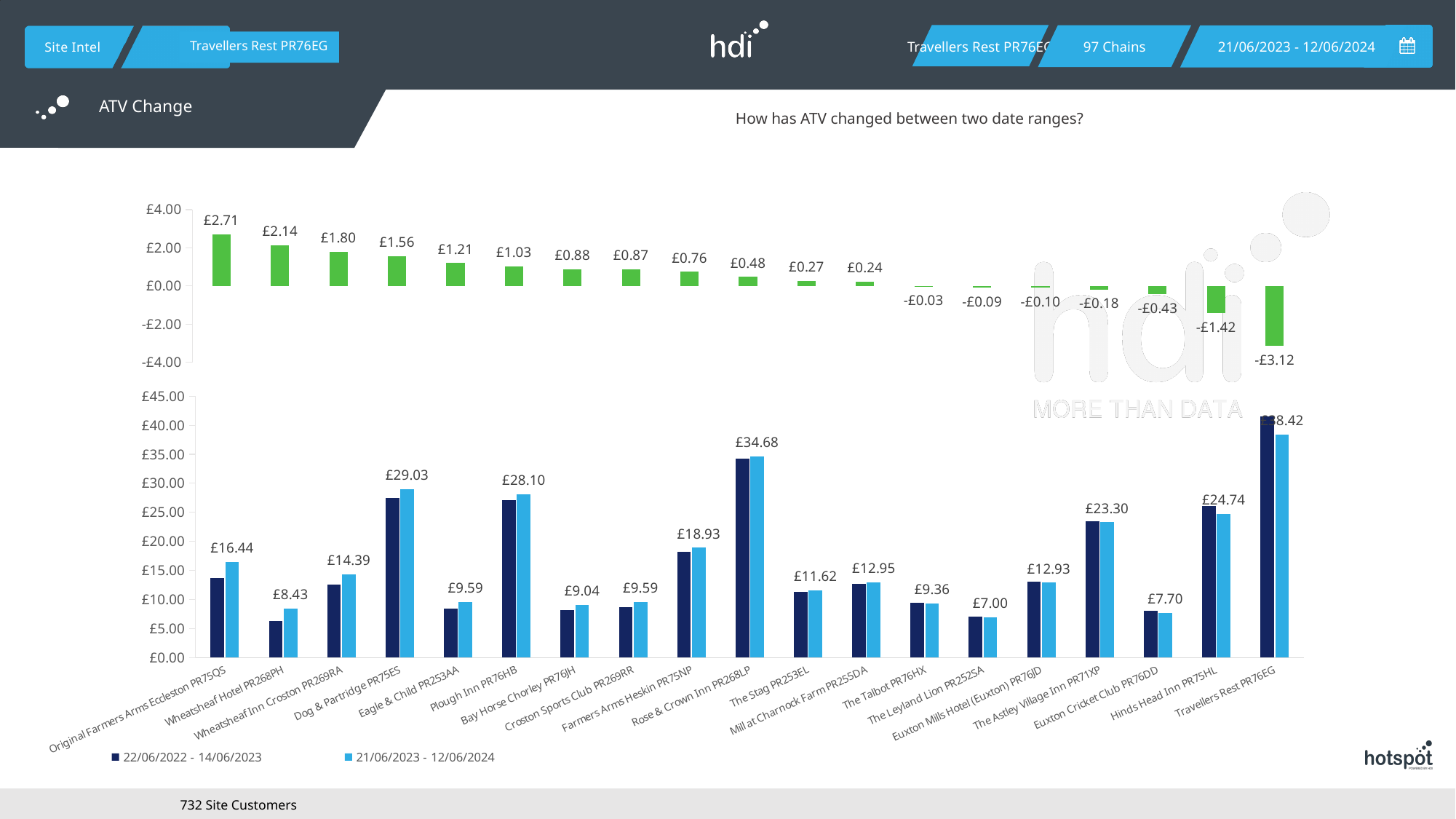
What kind of chart is the bottom chart? bar chart In the top chart, what is the difference between the values for Dog & Partridge PR75ES and Plough Inn PR76HB? £0.53 How many series does the legend of the bottom chart list? 2 In the bottom chart, is the 22/06/2022 - 14/06/2023 value for Dog & Partridge PR75ES greater or less than £25.00? greater How many sites are shown on the x axis of the bottom chart? 19 In the top chart, which site has the lowest value? Travellers Rest PR76EG In the top chart, which site has the highest value? Original Farmers Arms Eccleston PR75QS In the top chart, what is the value for Original Farmers Arms Eccleston PR75QS? £2.71 In the bottom chart, which has the larger labelled value: Travellers Rest PR76EG or Rose & Crown Inn PR268LP? Travellers Rest PR76EG In the top chart, what is the value for Hinds Head Inn PR75HL? -£1.42 In the bottom chart, what is the labelled value for Rose & Crown Inn PR268LP? £34.68 In the top chart, do the values rise or fall from left to right along the x axis? fall